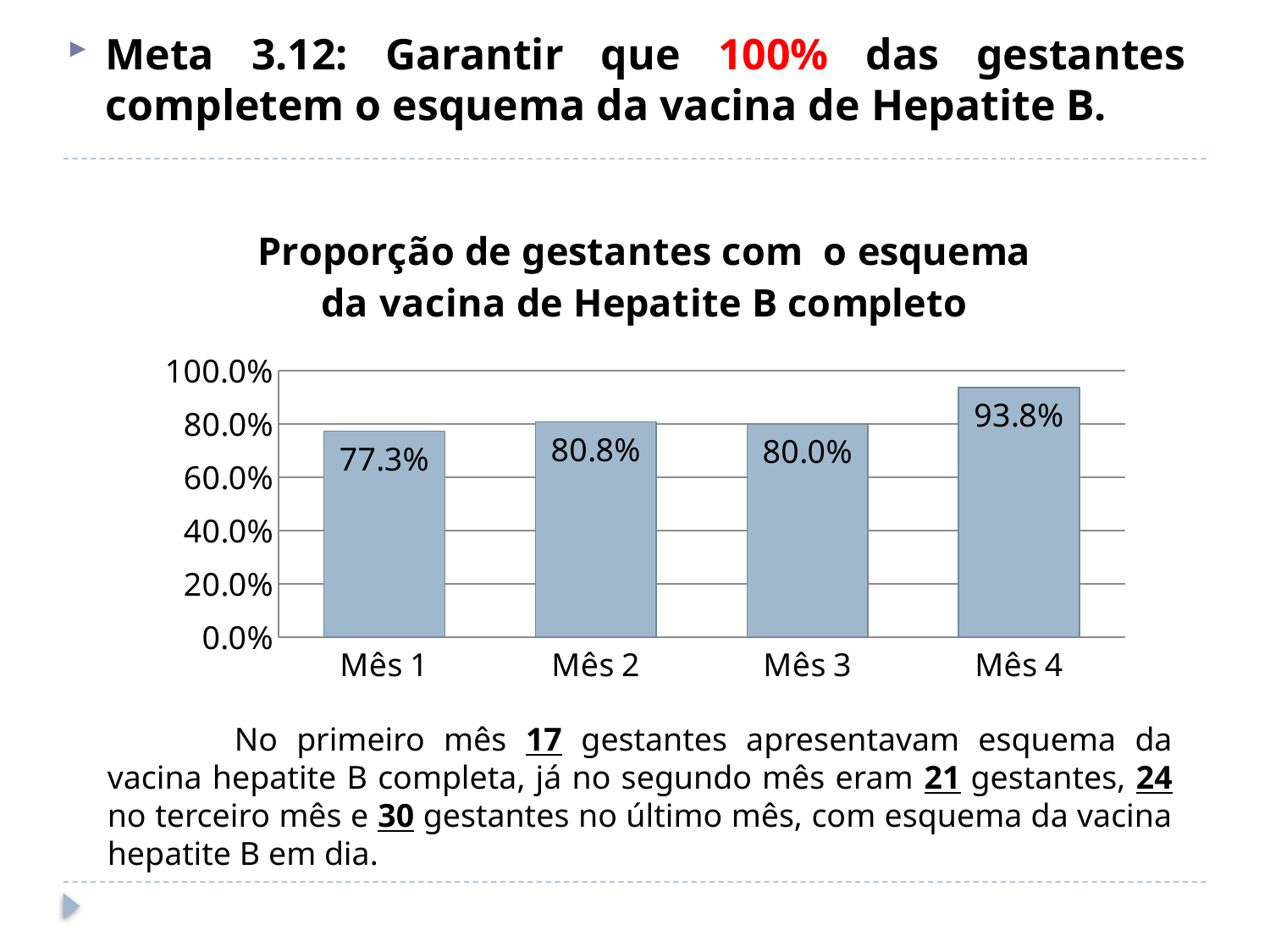
What is the value for Mês 3? 80.0% What is the difference between the values for Mês 4 and Mês 1? 16.5% How many months are shown on the x axis? 4 What is the value for Mês 4? 93.8% What is the value for Mês 1? 77.3% What is the title of the chart? Proporção de gestantes com o esquema da vacina de Hepatite B completo Which is larger, the value for Mês 2 or the value for Mês 3? Mês 2 Is the value for Mês 4 greater or less than 80.0%? greater Which month has the highest proportion? Mês 4 Which month has the lowest proportion? Mês 1 What kind of chart is shown on the slide? Bar chart What is the value for Mês 2? 80.8%